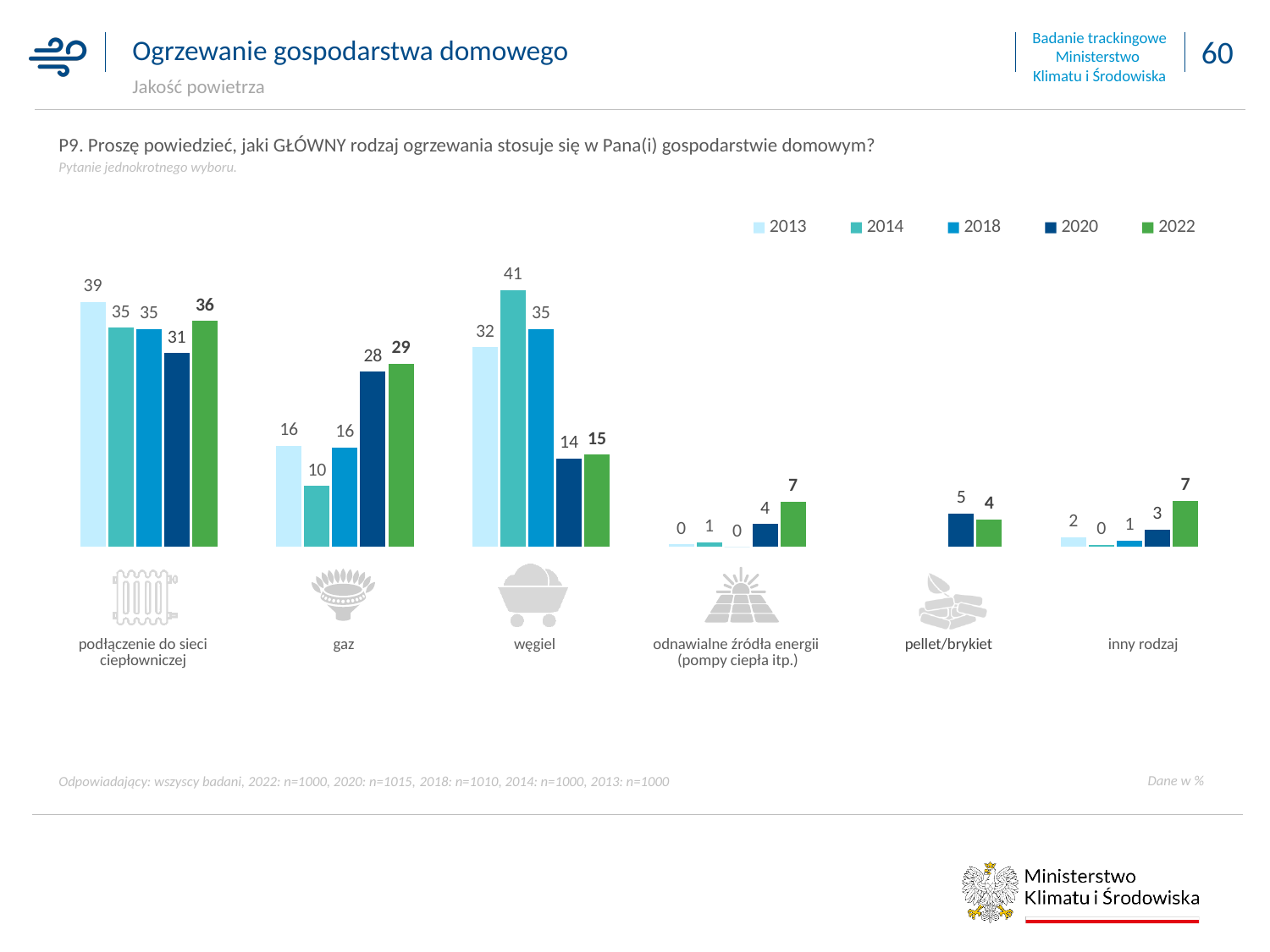
How many heating categories are shown on the x axis? 6 Which year is shown in green in the legend? 2022 Which year has the lowest value for 'gaz'? 2014 Which is larger for 'pellet/brykiet': the 2020 value or the 2022 value? 2020 Which category has the highest value in 2022? podłączenie do sieci ciepłowniczej What is the value for 'gaz' in 2020? 28 What is the value for 'odnawialne źródła energii (pompy ciepła itp.)' in 2022? 7 What is the difference between the 2014 and 2022 values for 'węgiel'? 26 What is the value for 'węgiel' in 2014? 41 What kind of chart is shown on the slide? bar chart How many series does the legend list? 5 What is the value for 'podłączenie do sieci ciepłowniczej' in 2022? 36